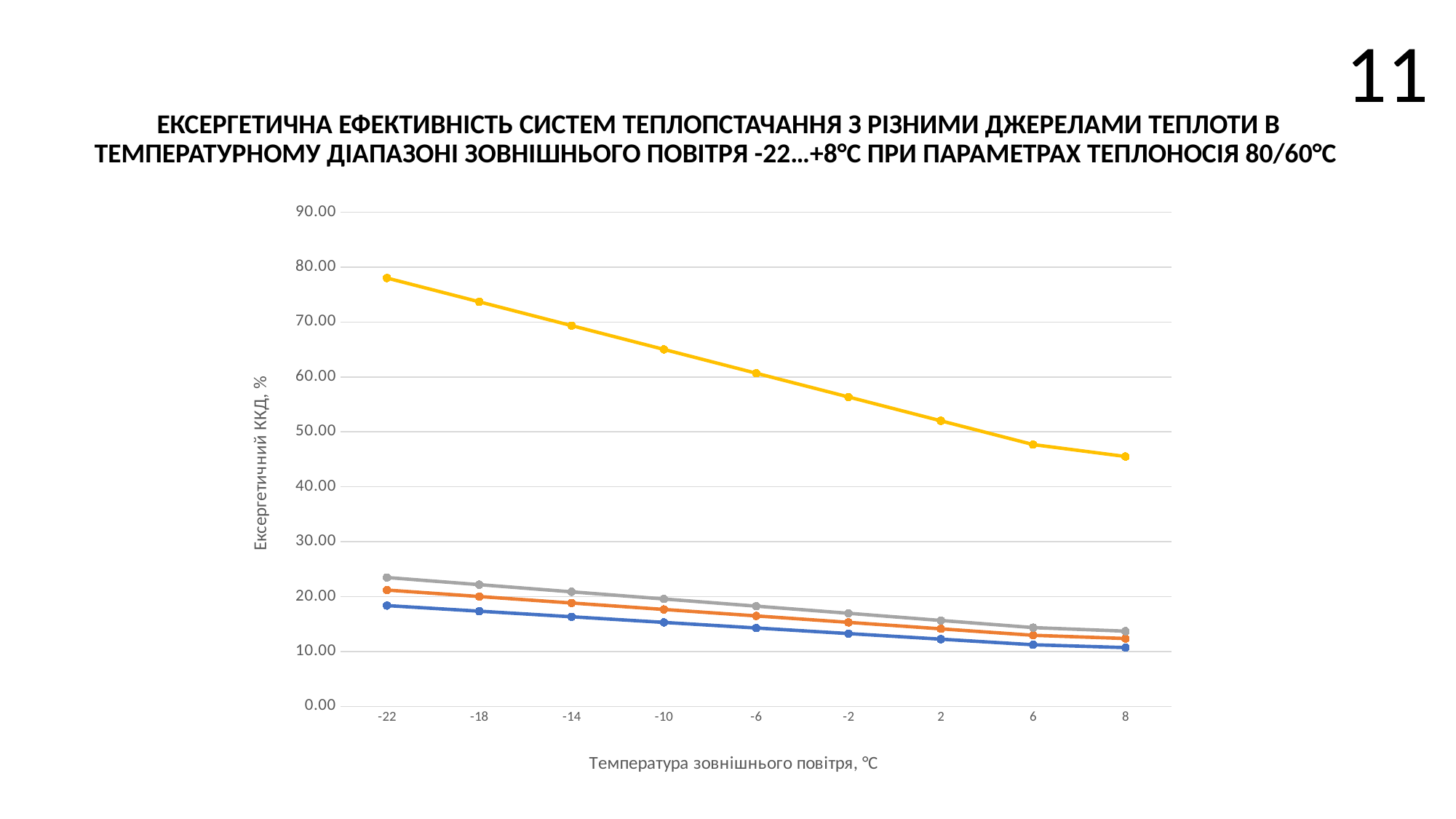
What kind of chart is shown on the slide? line chart How many outdoor air temperature points are plotted along the x axis? 9 Is the value of the blue line at -22 greater or less than 20? less Which line has the lowest values across the whole temperature range? the blue line Is the value of the yellow line at -22 greater or less than 70? greater What is the title of the vertical axis? Ексергетичний ККД, % Do the values of the yellow line rise or fall as the outdoor air temperature increases from -22 to 8? fall How many lines are plotted on the chart? 4 Is the value of the yellow line at 8 greater or less than 50? less At -22, which is larger: the value of the yellow line or the value of the blue line? the yellow line Which line has the highest values across the whole temperature range? the yellow line